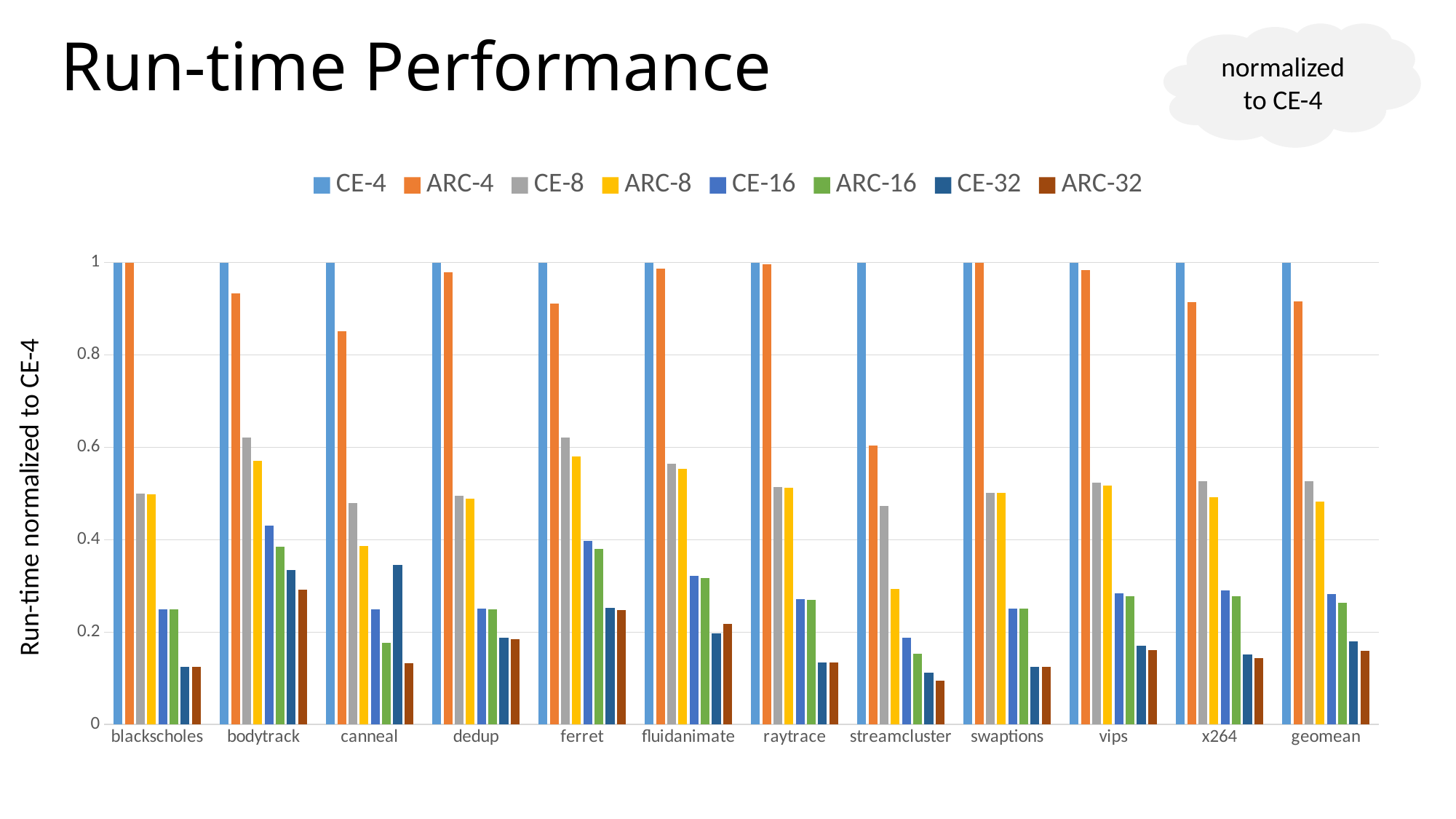
Which series has the lowest value for canneal? ARC-32 Is the value of ARC-4 for streamcluster greater or less than 0.8? less Is the value of CE-32 for canneal greater or less than 0.2? greater What kind of chart is shown on the slide? bar chart How many benchmark categories are shown along the x axis? 12 Is the value of ARC-4 for bodytrack greater or less than 0.8? greater What is the title of the y axis? Run-time normalized to CE-4 For streamcluster, which is larger: ARC-4 or CE-8? ARC-4 What is the value of CE-4 for blackscholes? 1 For canneal, which is larger: CE-32 or ARC-32? CE-32 What is the value of CE-4 for geomean? 1 How many series does the legend list? 8